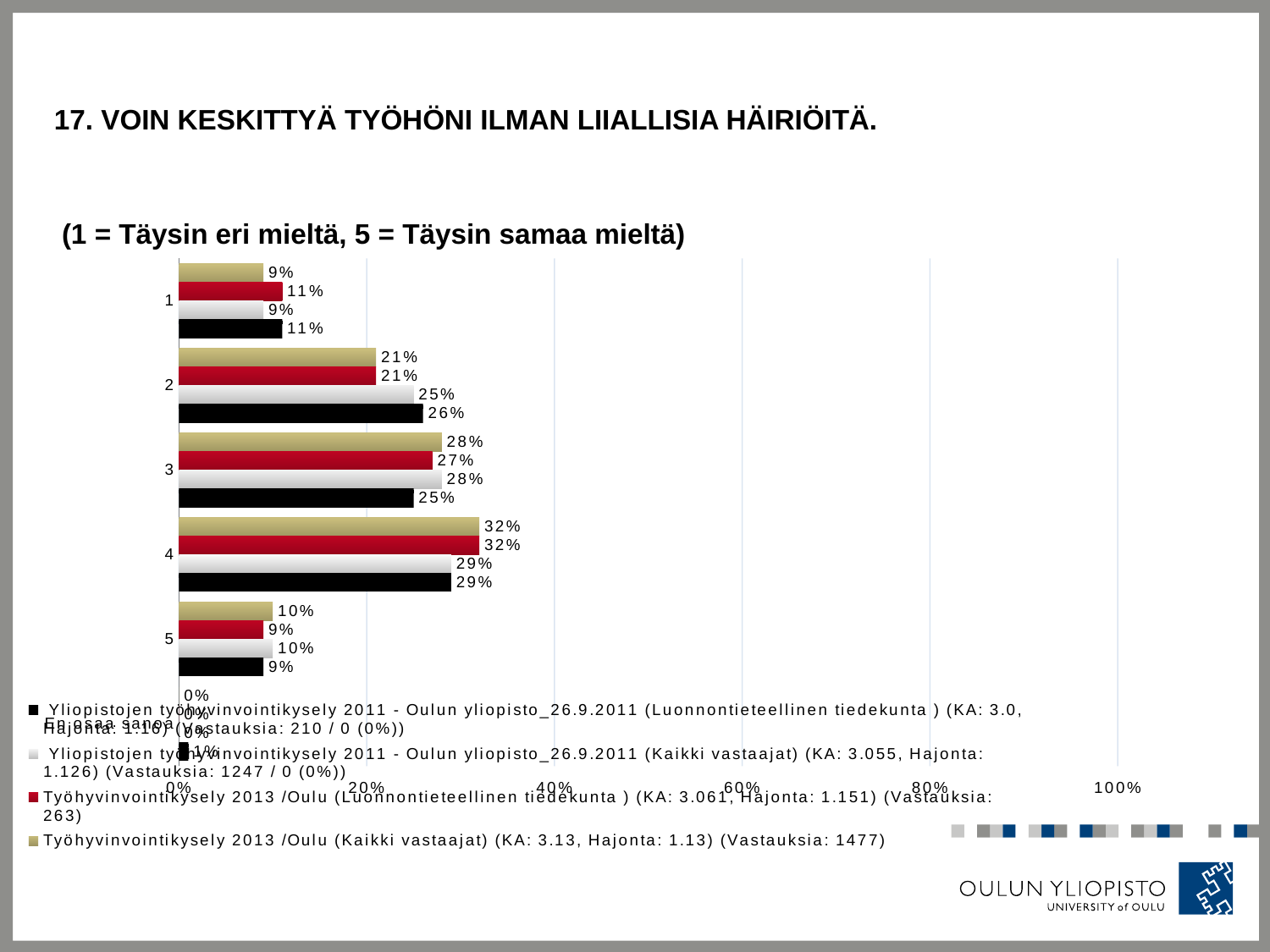
What is the title of the slide? 17. VOIN KESKITTYÄ TYÖHÖNI ILMAN LIIALLISIA HÄIRIÖITÄ. Is the value for category 4 in the Yliopistojen työhyvinvointikysely 2011 (Kaikki vastaajat) series greater or less than 20%? greater Which category has the lowest value in the Työhyvinvointikysely 2013 /Oulu (Luonnontieteellinen tiedekunta) series? En osaa sanoa What is the difference between the values for category 4 and category 1 in the Työhyvinvointikysely 2013 /Oulu (Luonnontieteellinen tiedekunta) series? 21% What is the value for category 4 in the Työhyvinvointikysely 2013 /Oulu (Kaikki vastaajat) series? 32% For category 2, which is larger: the Yliopistojen työhyvinvointikysely 2011 (Kaikki vastaajat) value or the Työhyvinvointikysely 2013 /Oulu (Kaikki vastaajat) value? Yliopistojen työhyvinvointikysely 2011 (Kaikki vastaajat) What is the value for category 3 in the Työhyvinvointikysely 2013 /Oulu (Luonnontieteellinen tiedekunta) series? 27% Which category has the highest value in the Työhyvinvointikysely 2013 /Oulu (Kaikki vastaajat) series? 4 What type of chart is shown on the slide? bar chart What is the value for category 2 in the Yliopistojen työhyvinvointikysely 2011 (Luonnontieteellinen tiedekunta) series? 26% What is the value for category 5 in the Yliopistojen työhyvinvointikysely 2011 (Kaikki vastaajat) series? 10% How many series does the legend list? 4